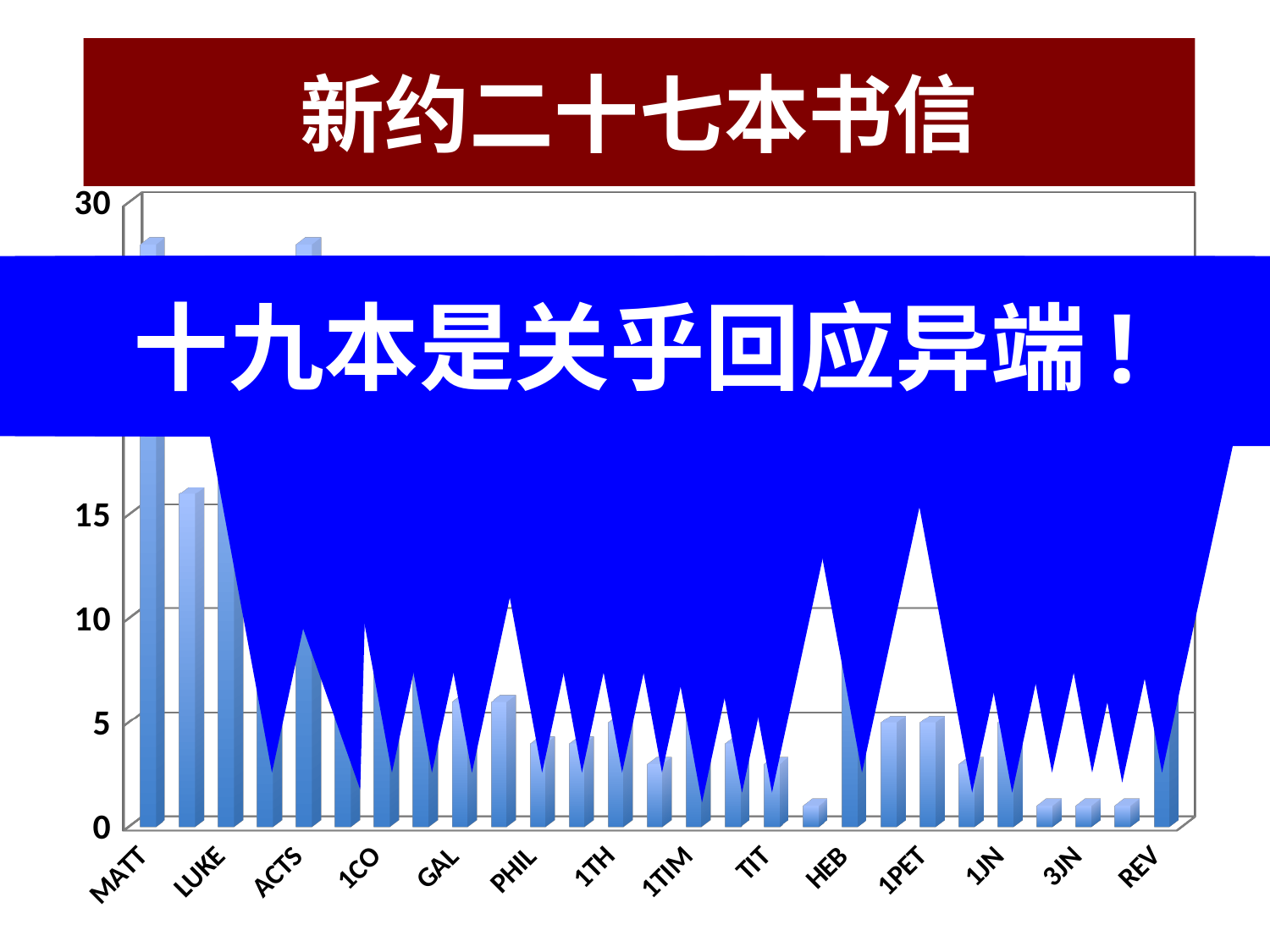
What is the highest value shown on the vertical axis? 30 Is the value for MATT greater or less than 15? greater How many category labels are printed along the horizontal axis? 14 Which is larger, the value for MATT or the value for ACTS? They are equal What is the title shown above the chart? 新约二十七本书信 Is the value for ACTS greater or less than 15? greater Is the value for MATT greater or less than 10? greater What kind of chart is shown on the slide? bar chart